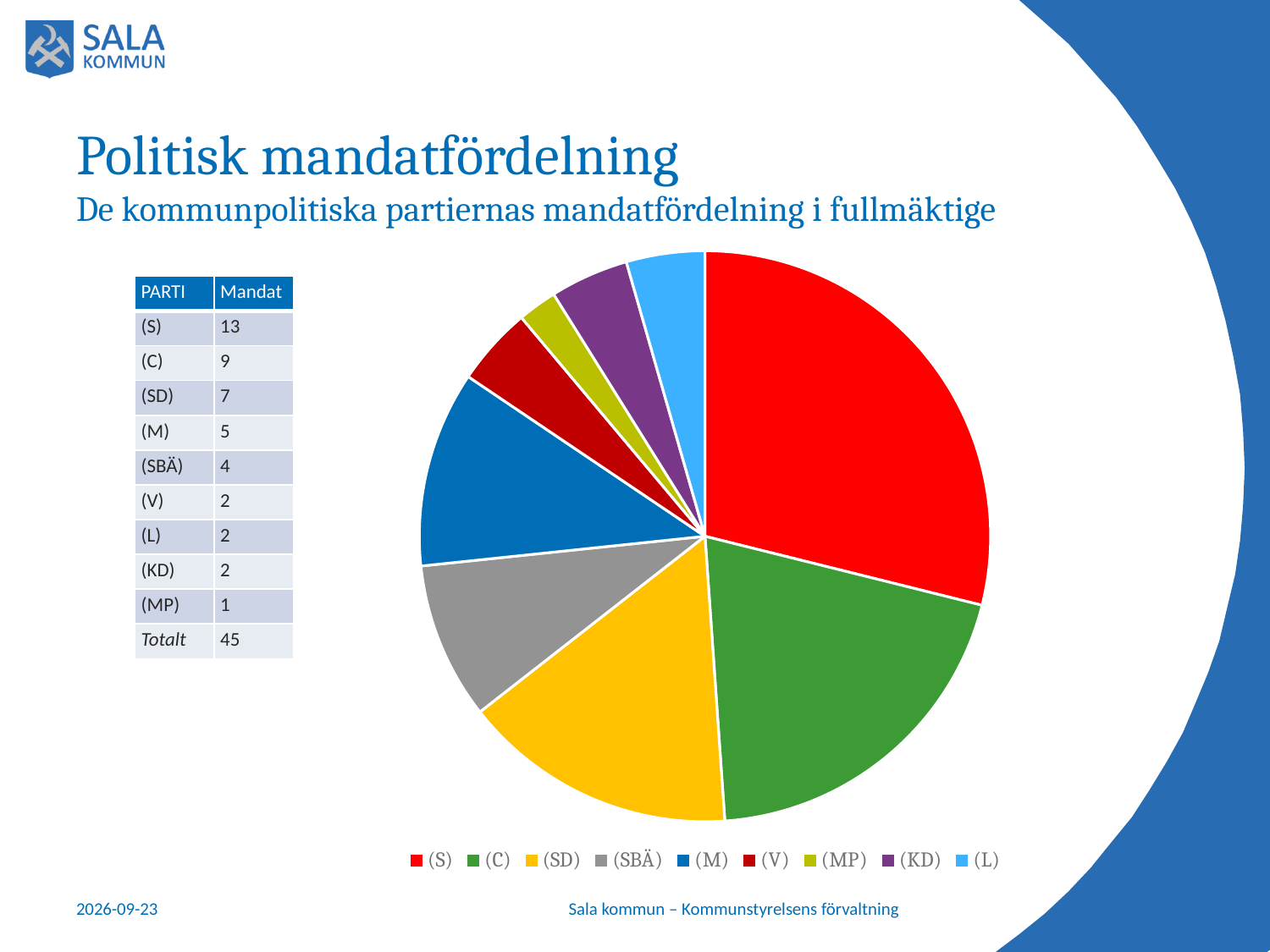
Which party has the largest slice of the pie chart? (S) Which party has the smallest slice of the pie chart? (MP) What colour is the (S) slice in the pie chart? red How many entries does the legend of the pie chart list? 9 How many slices does the pie chart have? 9 Which has more mandat, (SD) or (M)? (SD) What kind of chart is shown on the slide? pie chart What is the difference in mandat between (S) and (C)? 4 How many mandat does (SBÄ) have according to the slide? 4 How many mandat does (C) have according to the slide? 9 How many mandat does (S) have according to the slide? 13 What is the total number of mandat shown on the slide? 45